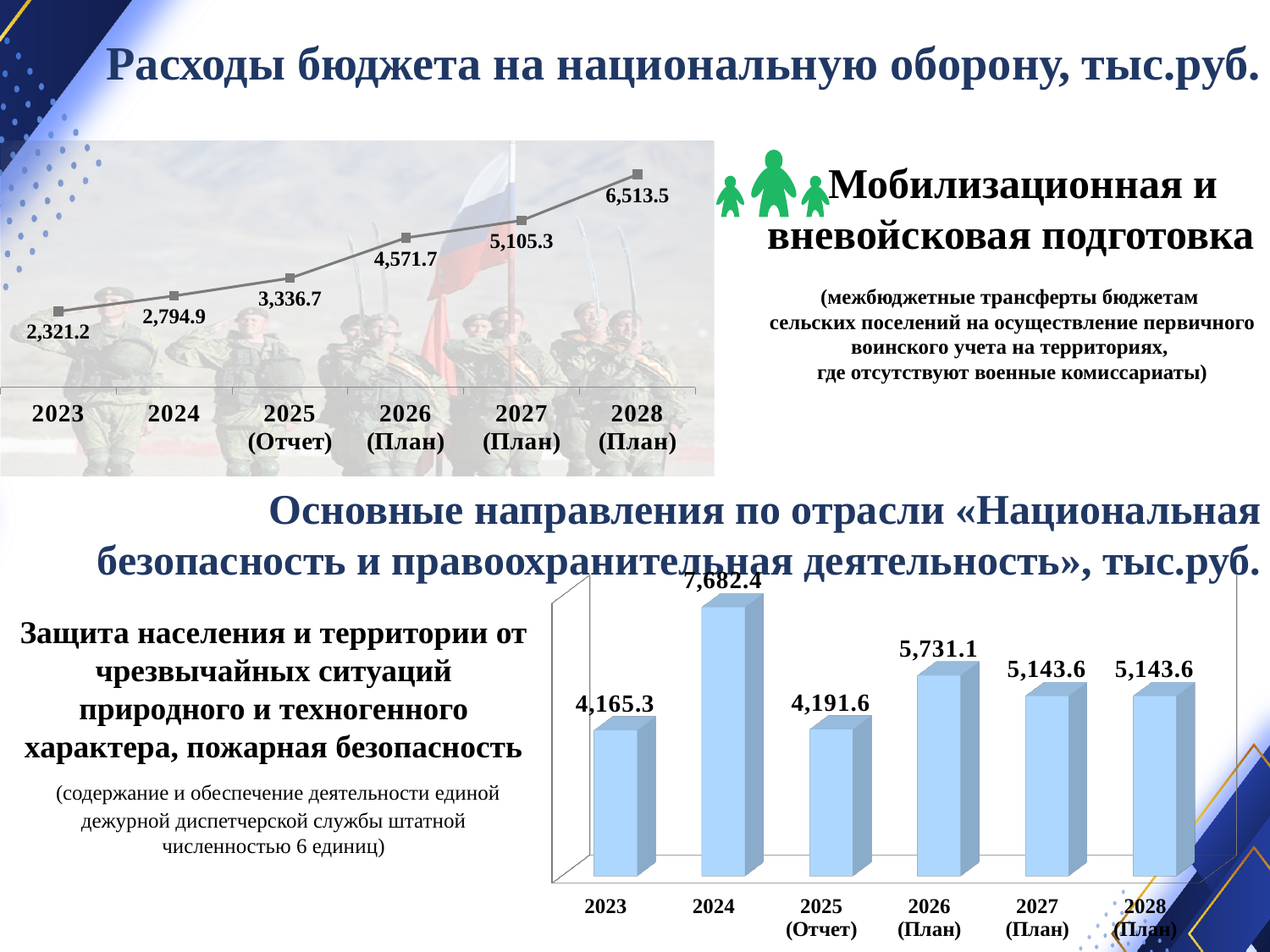
In the top line chart (Расходы бюджета на национальную оборону), which year has the highest value? 2028 (План) What kind of chart is the top chart on the slide? line chart In the top line chart (Расходы бюджета на национальную оборону), do the values rise or fall from 2023 to 2028? rise In the bottom bar chart (Защита населения и территории от чрезвычайных ситуаций), which year has the lowest value? 2023 What kind of chart is the bottom chart on the slide? bar chart In the bottom bar chart (Защита населения и территории от чрезвычайных ситуаций), which is larger: the value for 2026 (План) or the value for 2027 (План)? 2026 (План) In the bottom bar chart (Защита населения и территории от чрезвычайных ситуаций), what is the difference between the 2024 value and the 2025 (Отчет) value? 3,490.8 In the top line chart (Расходы бюджета на национальную оборону), what is the value for 2023? 2,321.2 In the top line chart (Расходы бюджета на национальную оборону), how many years are plotted? 6 In the top line chart (Расходы бюджета на национальную оборону), what is the difference between the 2028 (План) value and the 2027 (План) value? 1,408.2 In the bottom bar chart (Защита населения и территории от чрезвычайных ситуаций), what is the value for 2024? 7,682.4 In the top line chart (Расходы бюджета на национальную оборону), what is the value for 2026 (План)? 4,571.7